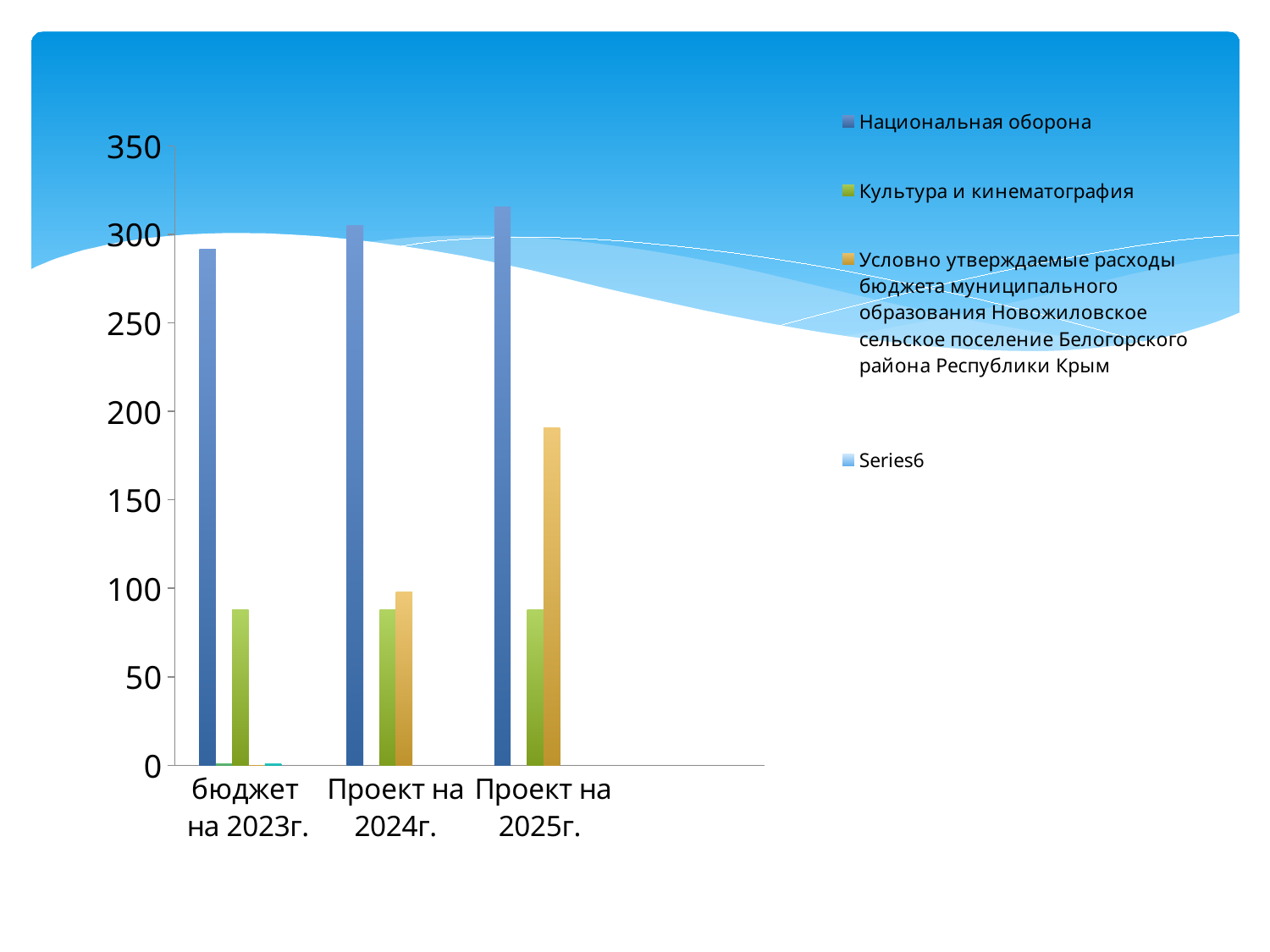
In Проект на 2025г., which is larger: Национальная оборона or Условно утверждаемые расходы? Национальная оборона What kind of chart is shown on the slide? bar chart In which category is the Национальная оборона bar the highest? Проект на 2025г. What is the name of the last series listed in the legend? Series6 Is the value for Условно утверждаемые расходы in Проект на 2025г. greater or less than 150? greater Do the values for Национальная оборона rise or fall from бюджет на 2023г. to Проект на 2025г.? rise How many categories are shown along the x axis? 3 Is the value for Национальная оборона in Проект на 2025г. greater or less than 300? greater Is the value for Культура и кинематография in Проект на 2024г. greater or less than 100? less In which category is the Условно утверждаемые расходы bar the lowest? бюджет на 2023г. How many series does the legend list? 4